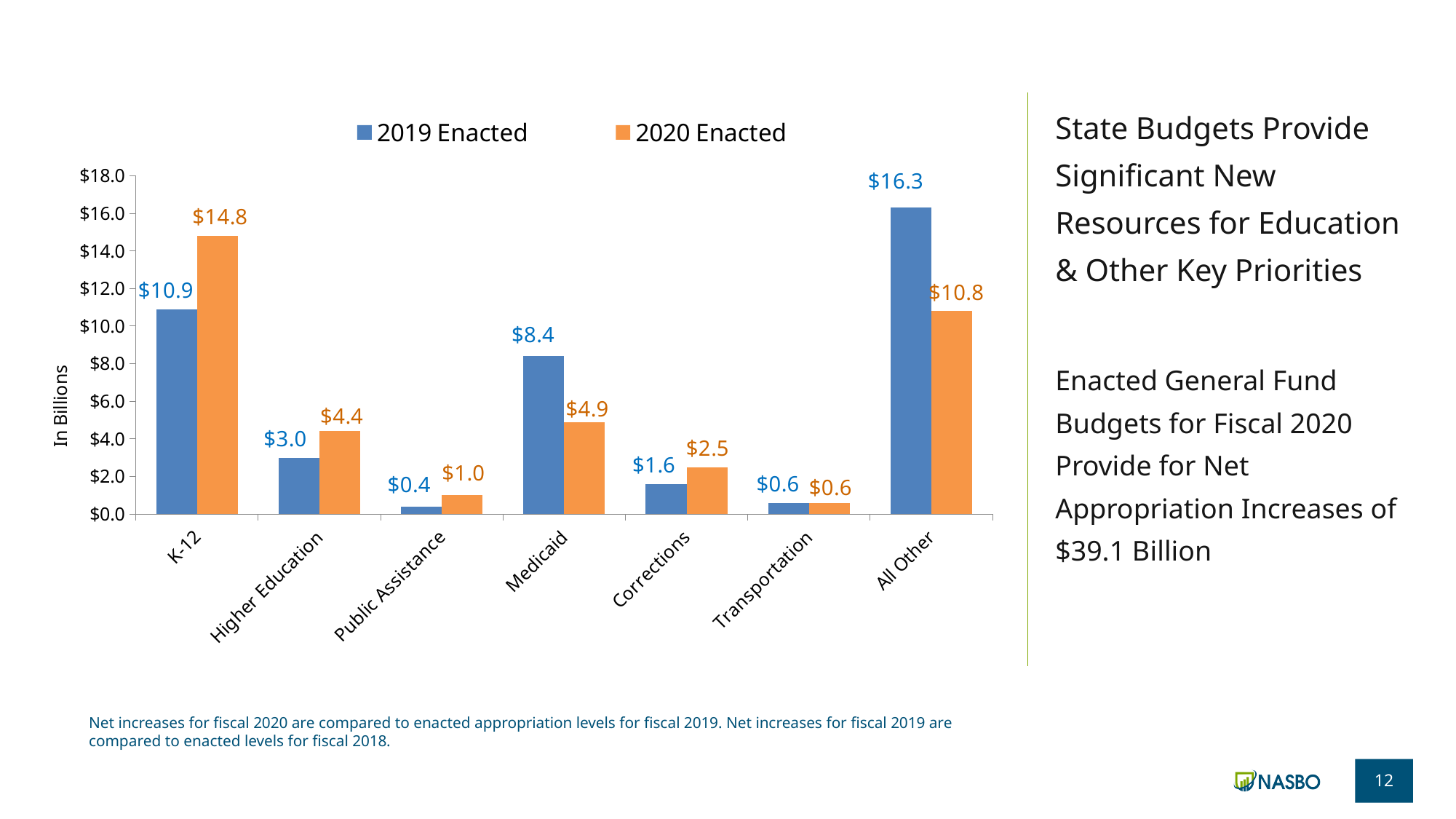
Is the 2019 Enacted value for All Other greater or less than $16.0? greater Which category has the lowest 2019 Enacted value? Public Assistance Which category has the highest 2019 Enacted value? All Other What is the 2020 Enacted value for Corrections? $2.5 What is the 2020 Enacted value for K-12? $14.8 What is the difference between the 2020 Enacted and 2019 Enacted values for K-12? $3.9 What is the label on the vertical axis? In Billions Which is larger for Medicaid: the 2019 Enacted value or the 2020 Enacted value? 2019 Enacted How many series does the legend list? 2 What kind of chart is shown on the slide? Bar chart What is the 2019 Enacted value for Medicaid? $8.4 How many categories are shown on the x axis? 7